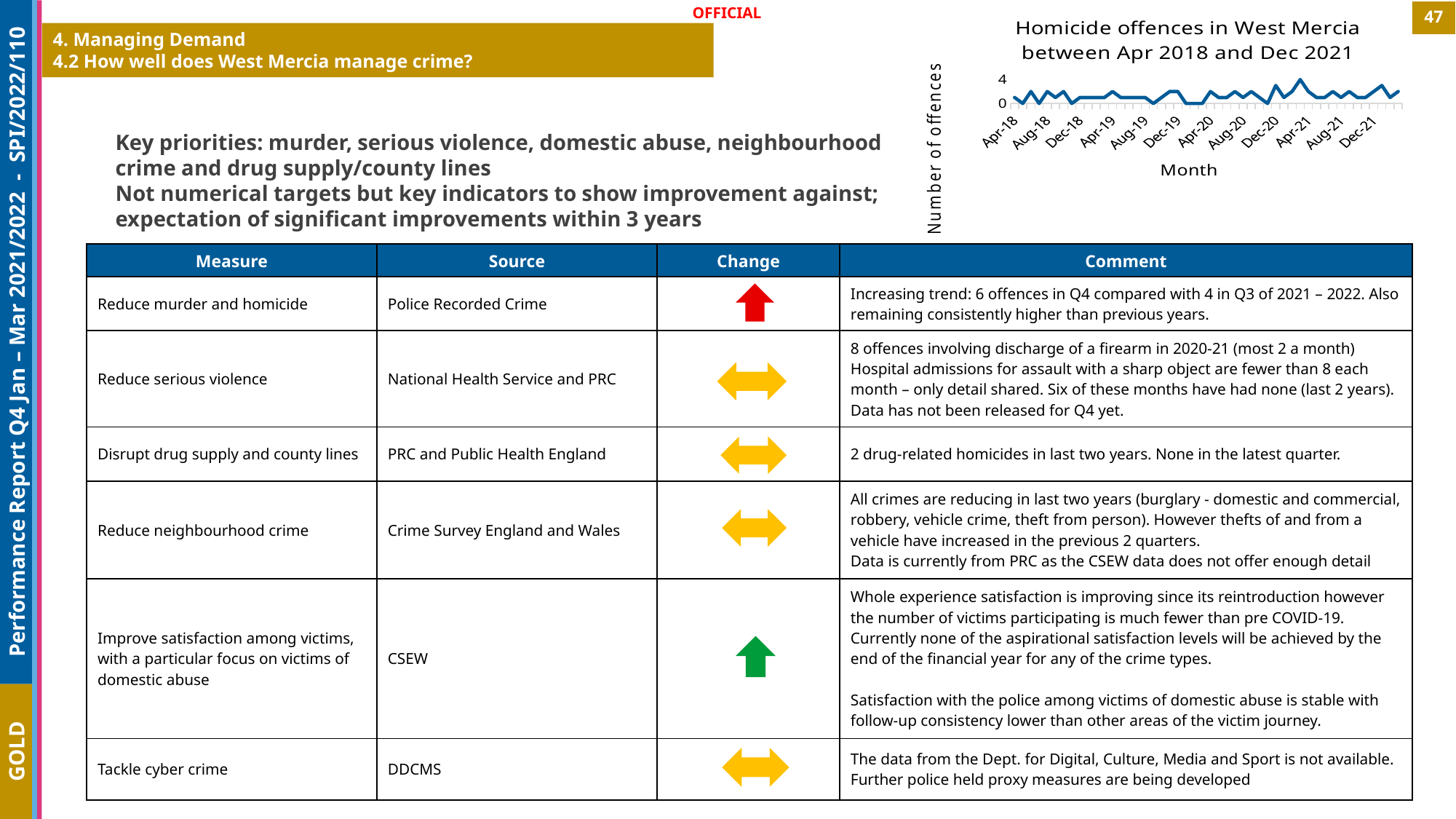
How many lines are plotted on the homicide offences chart? 1 How many month labels are printed along the x axis of the homicide offences chart? 12 What kind of chart is shown at the top right of the slide? line chart What is the title of the chart on the slide? Homicide offences in West Mercia between Apr 2018 and Dec 2021 What is the label on the vertical axis of the homicide offences chart? Number of offences On the homicide offences chart, is the value for Dec-21 greater or less than 4? less On the homicide offences chart, is the value for Apr-18 greater or less than 4? less On the homicide offences chart, is the value for Aug-19 greater or less than 4? less